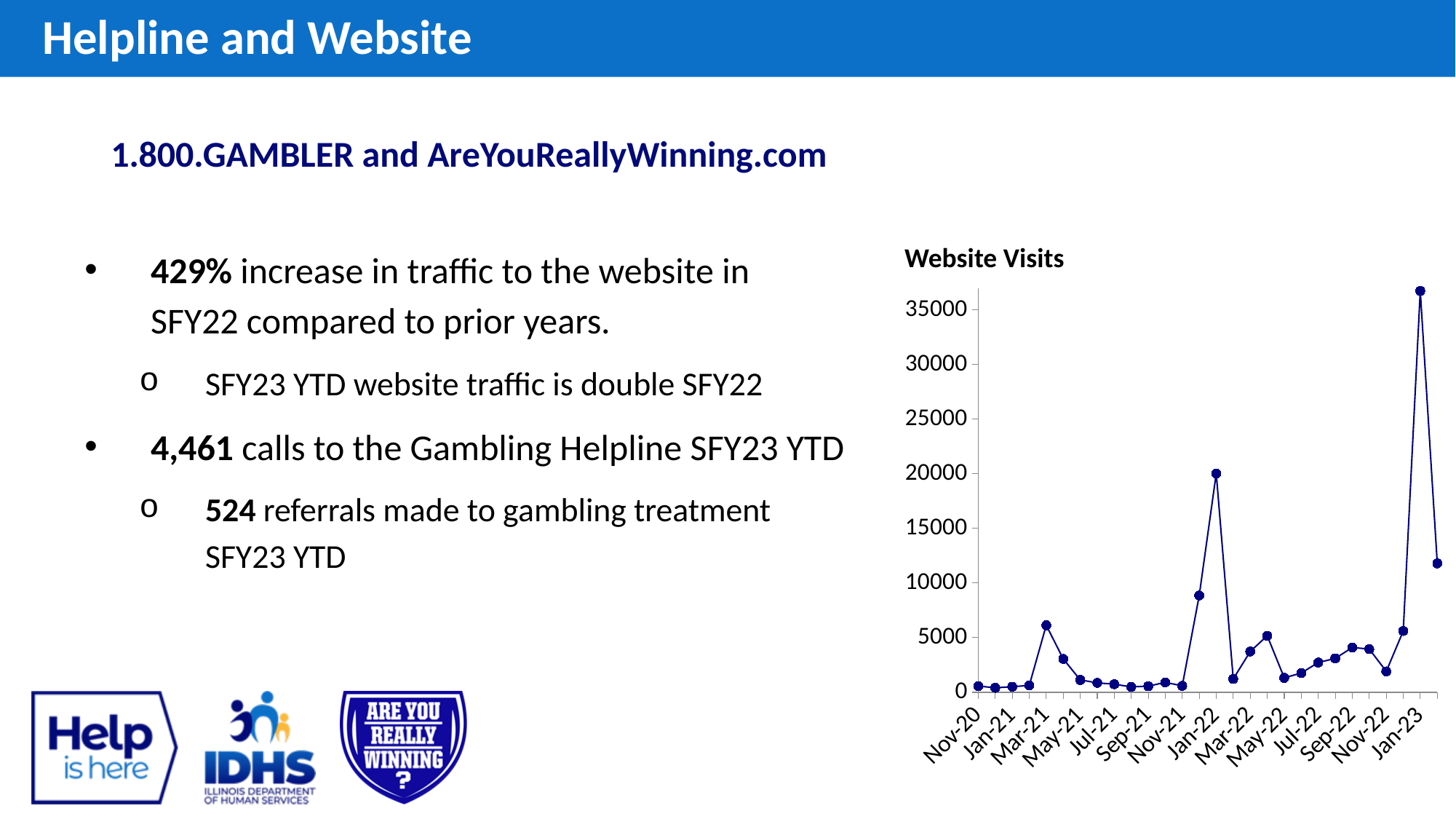
Do website visits rise or fall from Nov-22 to Jan-23? rise Which month has the highest number of website visits? Jan-23 Which is larger, the value for Mar-21 or the value for Jan-22? Jan-22 Is the value for Nov-22 greater or less than 5000? less Is the value for Nov-20 greater or less than 5000? less Which is larger, the value for Jan-22 or the value for Jan-23? Jan-23 Is the value for Jan-22 greater or less than 15000? greater What kind of chart is shown on the slide? line chart What is the highest value labelled on the vertical axis? 35000 What is the title of the chart? Website Visits